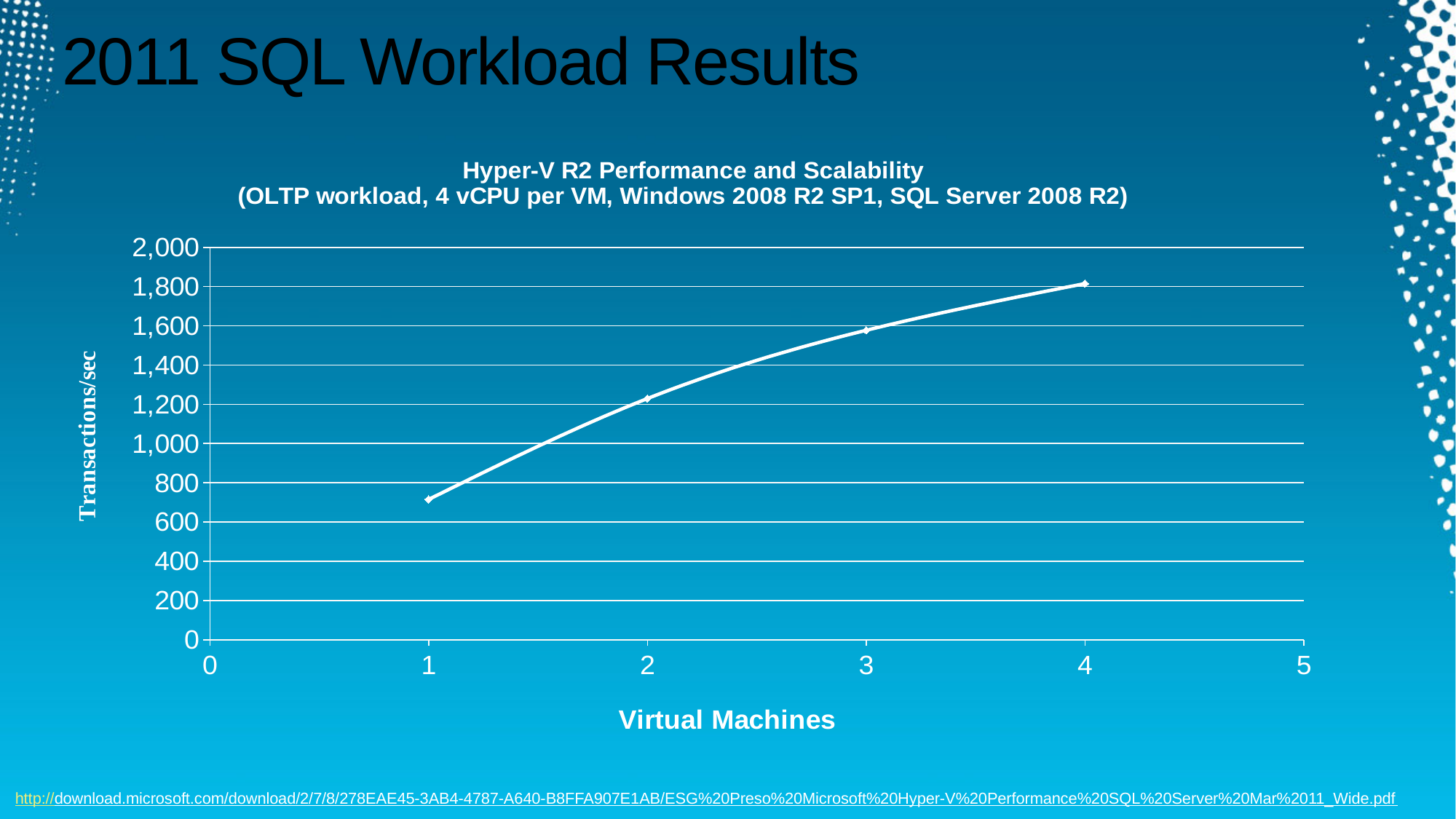
Is the transactions/sec value for 3 virtual machines greater or less than 1,400? greater At which number of virtual machines is the transactions/sec value highest? 4 At which number of virtual machines is the transactions/sec value lowest? 1 Is the transactions/sec value for 1 virtual machine greater or less than 600? greater What is the label of the y axis? Transactions/sec Is the transactions/sec value for 1 virtual machine greater or less than 800? less What kind of chart is shown on the slide? Line chart Do transactions/sec rise or fall as the number of virtual machines increases? Rise Which has a higher transactions/sec value: 2 virtual machines or 4 virtual machines? 4 virtual machines What is the title of the chart? Hyper-V R2 Performance and Scalability (OLTP workload, 4 vCPU per VM, Windows 2008 R2 SP1, SQL Server 2008 R2) How many data points are plotted on the line? 4